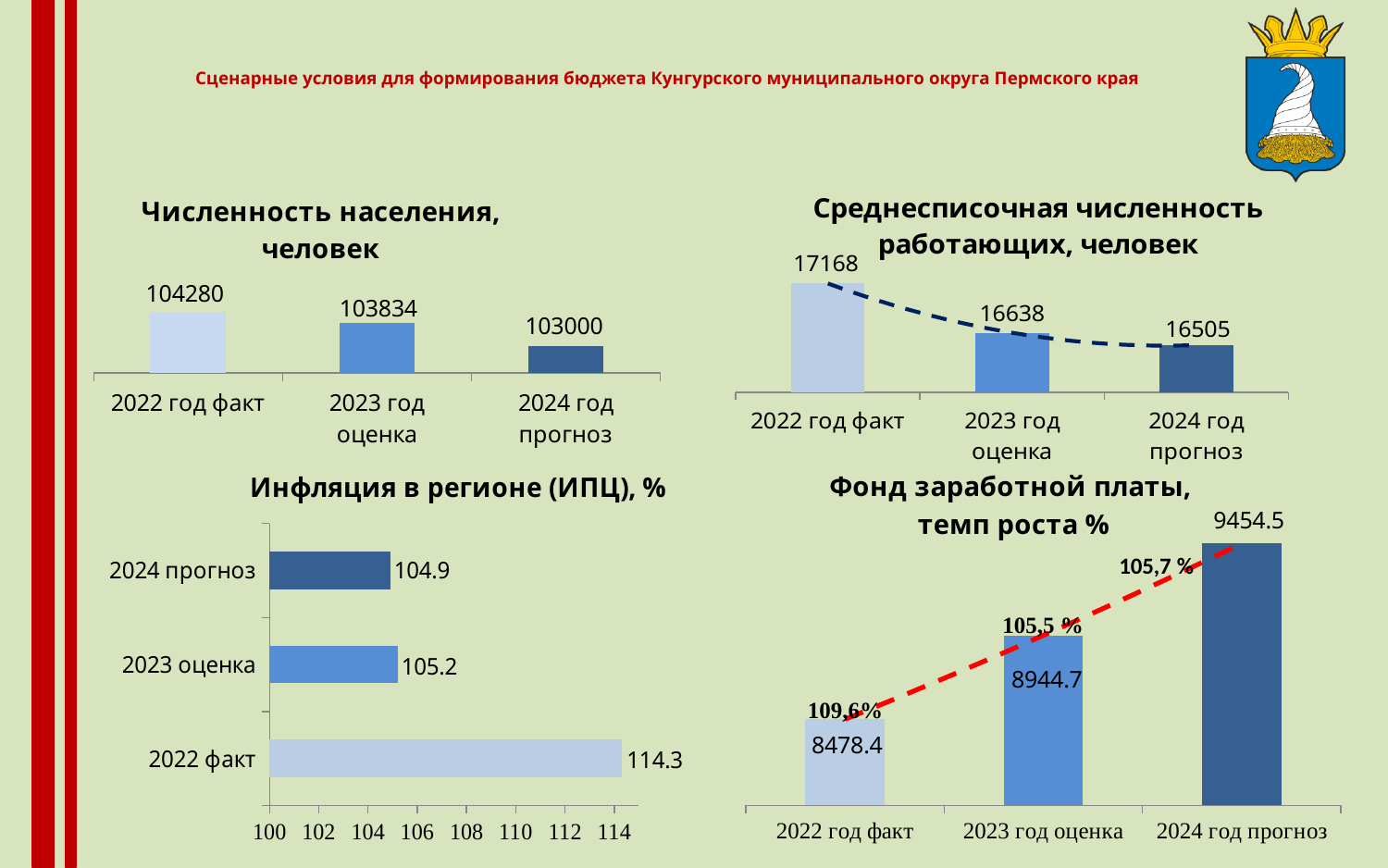
In the chart 'Среднесписочная численность работающих, человек', how many bars are plotted? 3 In the chart 'Инфляция в регионе (ИПЦ), %', which category has the highest value? 2022 факт In the chart 'Фонд заработной платы, темп роста %', what growth rate is shown for 2023 год оценка? 105,5 % In the chart 'Инфляция в регионе (ИПЦ), %', what is the value for 2023 оценка? 105.2 In the chart 'Численность населения, человек', what is the difference between the 2022 год факт and 2023 год оценка values? 446 In the chart 'Численность населения, человек', what is the value for 2022 год факт? 104280 In the chart 'Фонд заработной платы, темп роста %', what is the bar value for 2024 год прогноз? 9454.5 What kind of chart is 'Инфляция в регионе (ИПЦ), %'? bar chart In the chart 'Среднесписочная численность работающих, человек', what is the value for 2023 год оценка? 16638 In the chart 'Среднесписочная численность работающих, человек', do the values rise or fall from 2022 to 2024? fall In the chart 'Численность населения, человек', which category has the lowest value? 2024 год прогноз In the chart 'Фонд заработной платы, темп роста %', which is larger: the bar value for 2022 год факт or for 2023 год оценка? 2023 год оценка